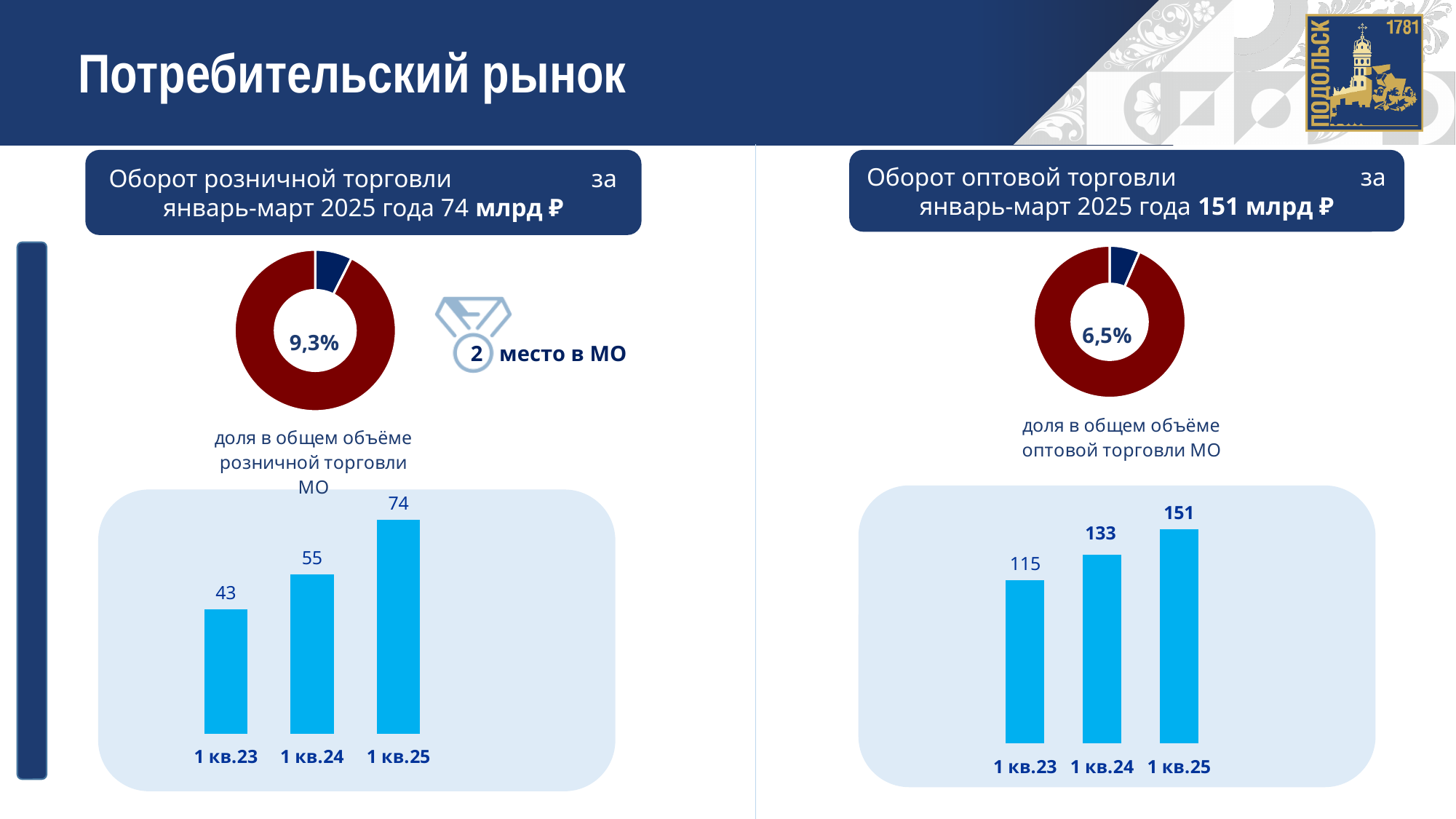
In the bar chart on the left (retail trade turnover), which period has the lowest value? 1 кв.23 In the bar chart on the right (wholesale trade turnover), which period has the highest value? 1 кв.25 In the bar chart on the right (wholesale trade turnover), which is larger: the value for 1 кв.23 or 1 кв.24? 1 кв.24 In the bar chart on the left (retail trade turnover), what is the value for 1 кв.25? 74 In the donut chart on the right (share in total wholesale trade of MO), what share is shown in the centre? 6,5% In the bar chart on the left (retail trade turnover), what is the value for 1 кв.23? 43 In the bar chart on the left (retail trade turnover), what is the difference between the values for 1 кв.25 and 1 кв.24? 19 Do the values in the bar chart on the right (wholesale trade turnover) rise or fall from 1 кв.23 to 1 кв.25? rise How many bars are in the bar chart on the left (retail trade turnover)? 3 In the bar chart on the right (wholesale trade turnover), what is the value for 1 кв.24? 133 In the donut chart on the left (share in total retail trade of MO), what share is shown in the centre? 9,3% In the bar chart on the right (wholesale trade turnover), what is the difference between the values for 1 кв.25 and 1 кв.23? 36